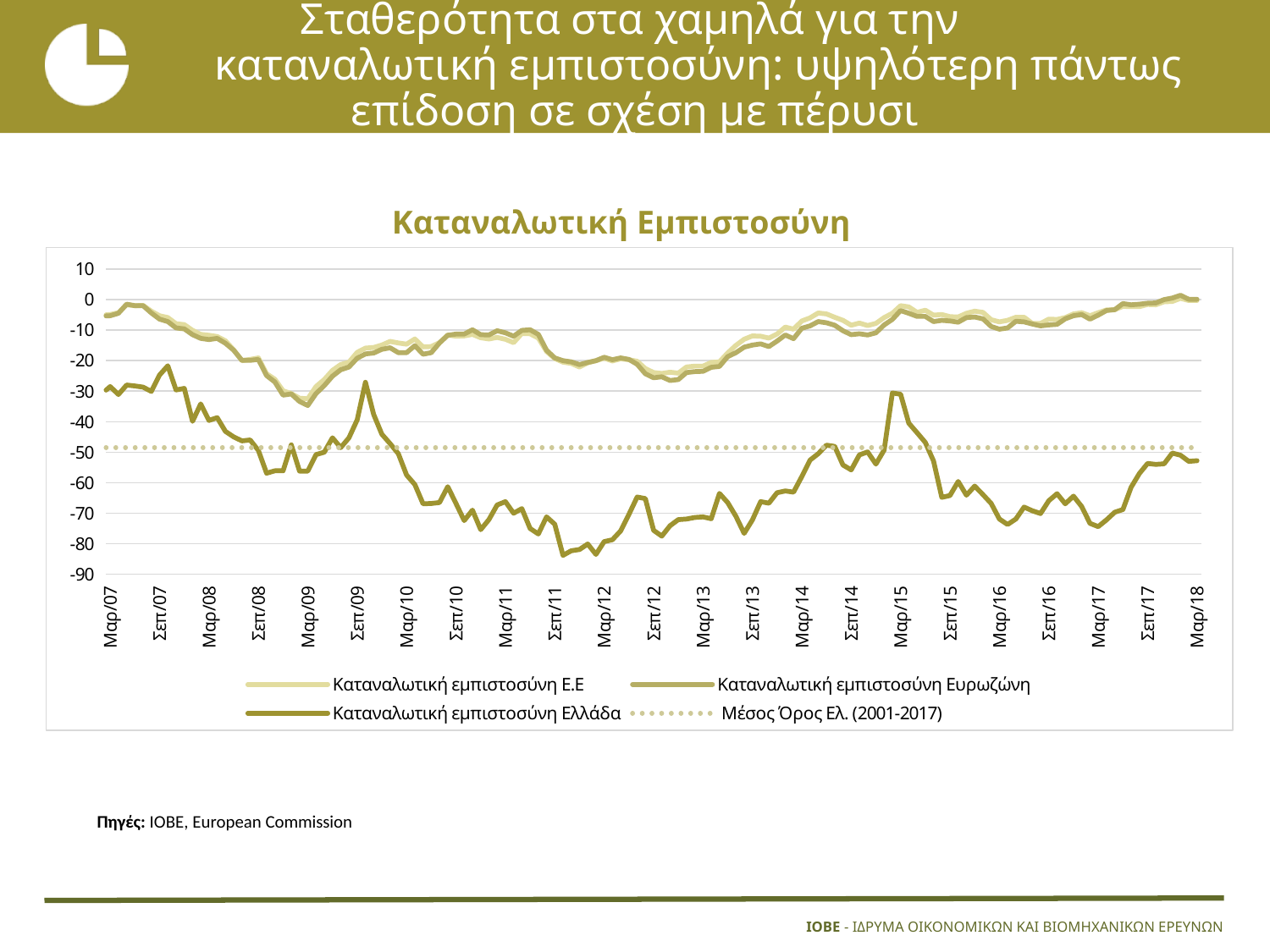
Which series has the lowest values across the whole period? Καταναλωτική εμπιστοσύνη Ελλάδα Is the value for Καταναλωτική εμπιστοσύνη Ελλάδα at Μαρ/18 greater or less than -40? less Is the Μέσος Όρος Ελ. (2001-2017) line greater or less than -60? greater Is the value for Καταναλωτική εμπιστοσύνη Ελλάδα at Σεπ/11 greater or less than -70? less Does the Καταναλωτική εμπιστοσύνη Ελλάδα line rise or fall between Μαρ/17 and Μαρ/18? rise How many series does the legend list? 4 At Μαρ/18, which is higher: Καταναλωτική εμπιστοσύνη Ε.Ε or Καταναλωτική εμπιστοσύνη Ελλάδα? Καταναλωτική εμπιστοσύνη Ε.Ε What is the title of the chart? Καταναλωτική Εμπιστοσύνη Which series is drawn as a dotted line? Μέσος Όρος Ελ. (2001-2017) What kind of chart is shown on the slide? line chart